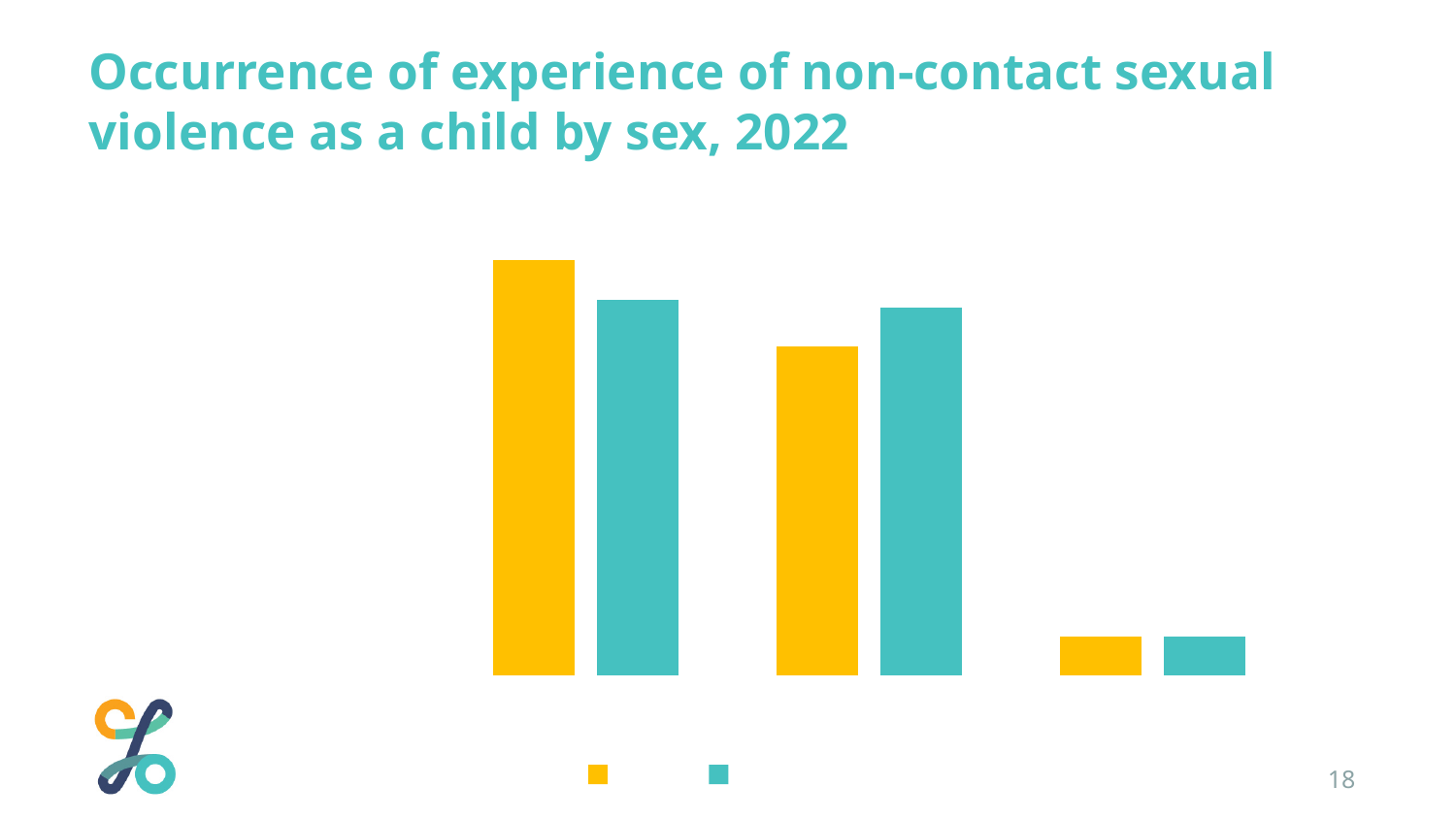
How many groups of bars are plotted along the x axis? 3 How many series does the legend list? 2 What is the title of the chart on the slide? Occurrence of experience of non-contact sexual violence as a child by sex, 2022 Do the yellow bars rise or fall from left to right along the x axis? fall Which year does the chart title refer to? 2022 What two colours are used for the bars in the chart? yellow and teal Do the teal bars rise or fall from left to right along the x axis? fall What kind of chart is shown on the slide? bar chart How many bars are plotted in the chart? 6